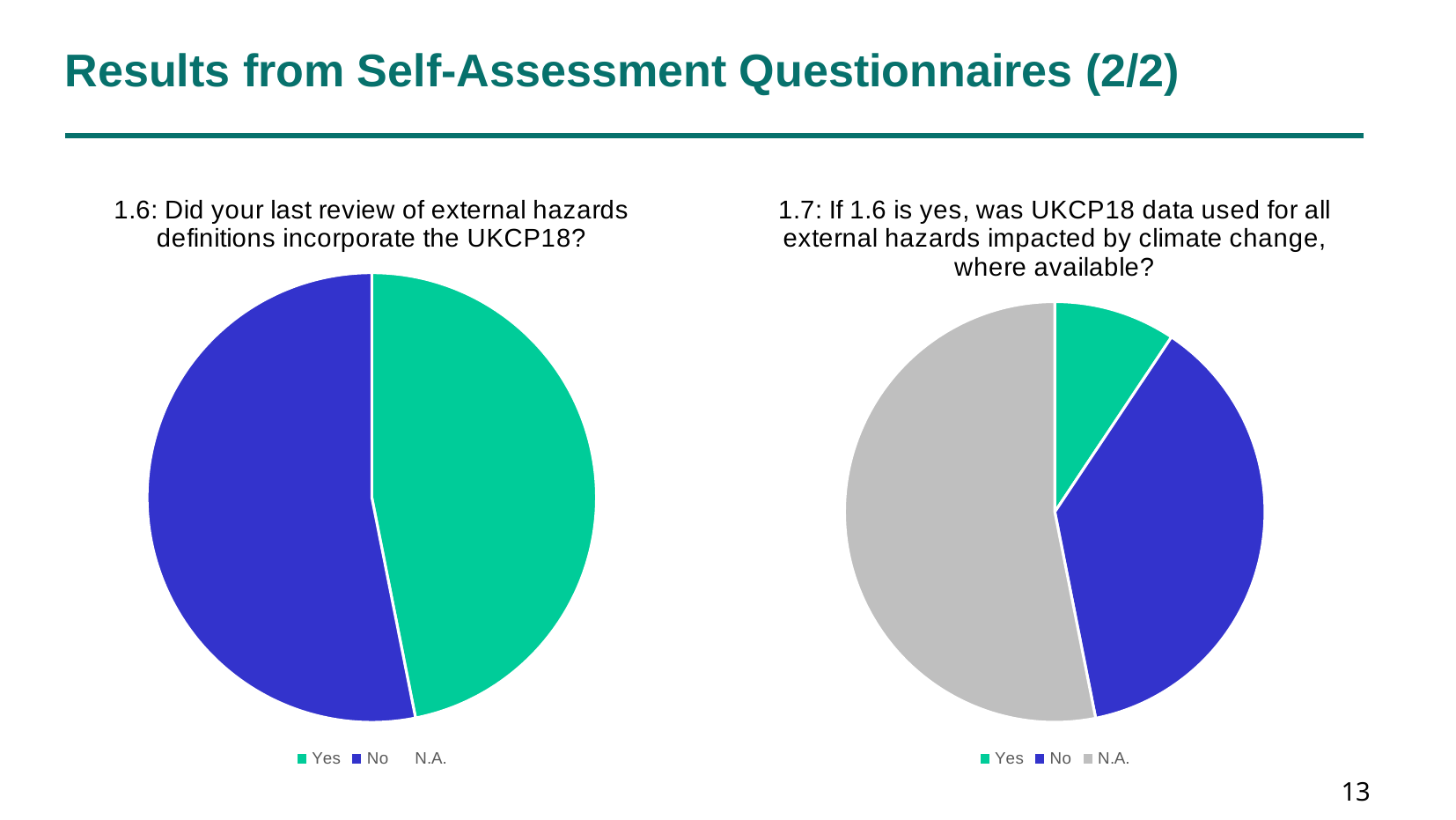
How many entries does the legend of the right-hand chart (1.7) list? 3 What kind of chart is used for question 1.6 on the left of the slide? Pie chart In the left-hand chart (1.6), which colour represents the 'No' response? Blue What is the title of the left-hand pie chart? 1.6: Did your last review of external hazards definitions incorporate the UKCP18? In the right-hand chart (1.7), which response has the smallest share of the pie? Yes What kind of chart is used for question 1.7 on the right of the slide? Pie chart In the right-hand chart (1.7), which slice is larger, Yes or No? No In the right-hand chart (1.7), which response has the largest share of the pie? N.A. How many slices are visible in the left-hand chart (1.6)? 2 In the right-hand chart (1.7), which slice is larger, No or N.A.? N.A. How many slices are visible in the right-hand chart (1.7)? 3